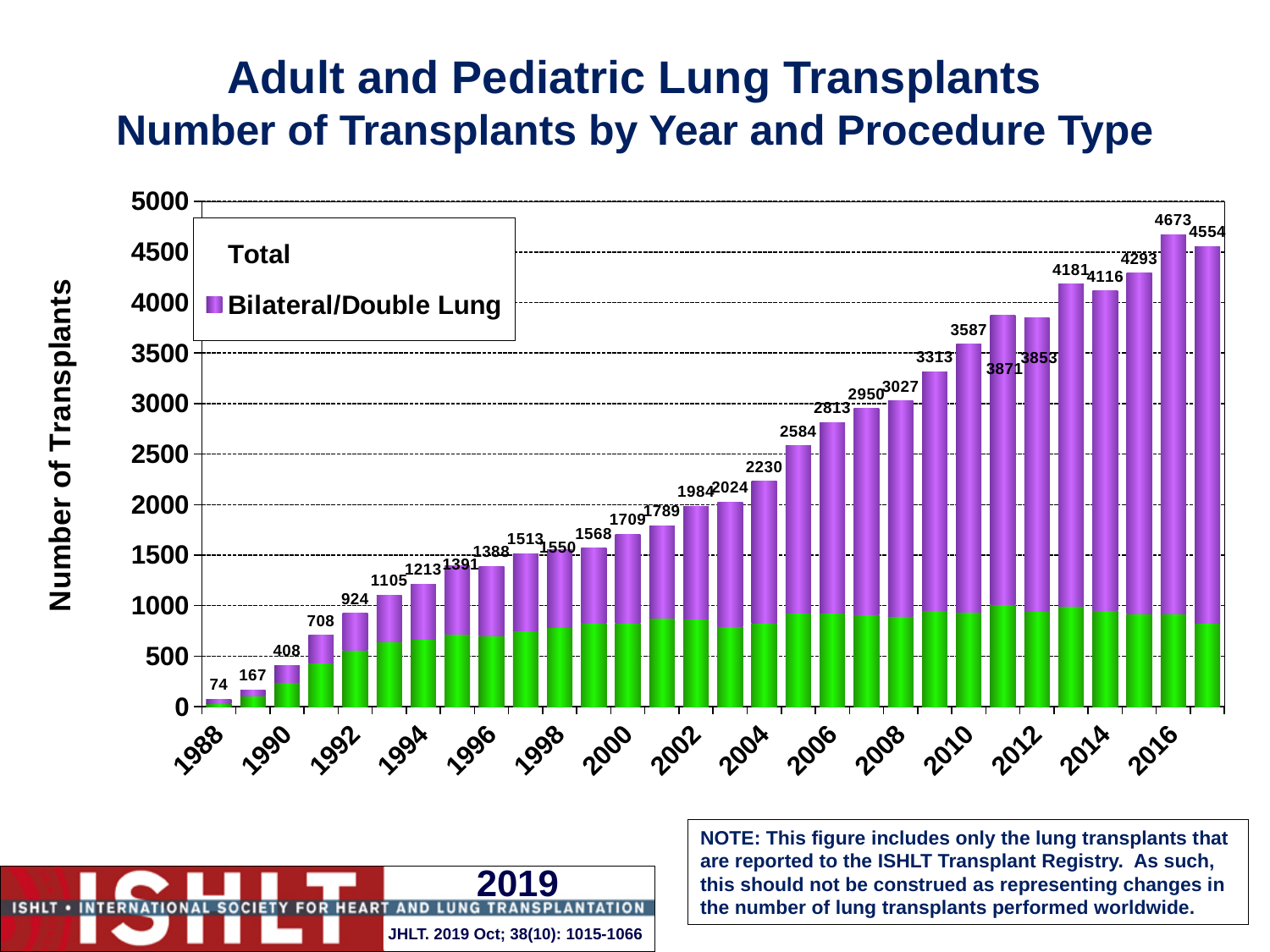
By how much did the total number of transplants decrease from 2016 to 2017? 119 What is the total number of lung transplants shown for 2010? 3587 What is the total number of lung transplants shown for 1988? 74 Which year had a higher total, 2011 or 2012? 2011 What is the total number of lung transplants shown for 2004? 2230 Which year has the highest total number of transplants? 2016 How many years (bars) are plotted in the chart? 30 What kind of chart is shown on the slide? Stacked bar chart Which year has the lowest total number of transplants? 1988 Which series does the purple colour represent in the legend? Bilateral/Double Lung Is the green (lower) segment of the 2016 bar greater or less than 1000? less What is the total number of lung transplants shown for 2016? 4673